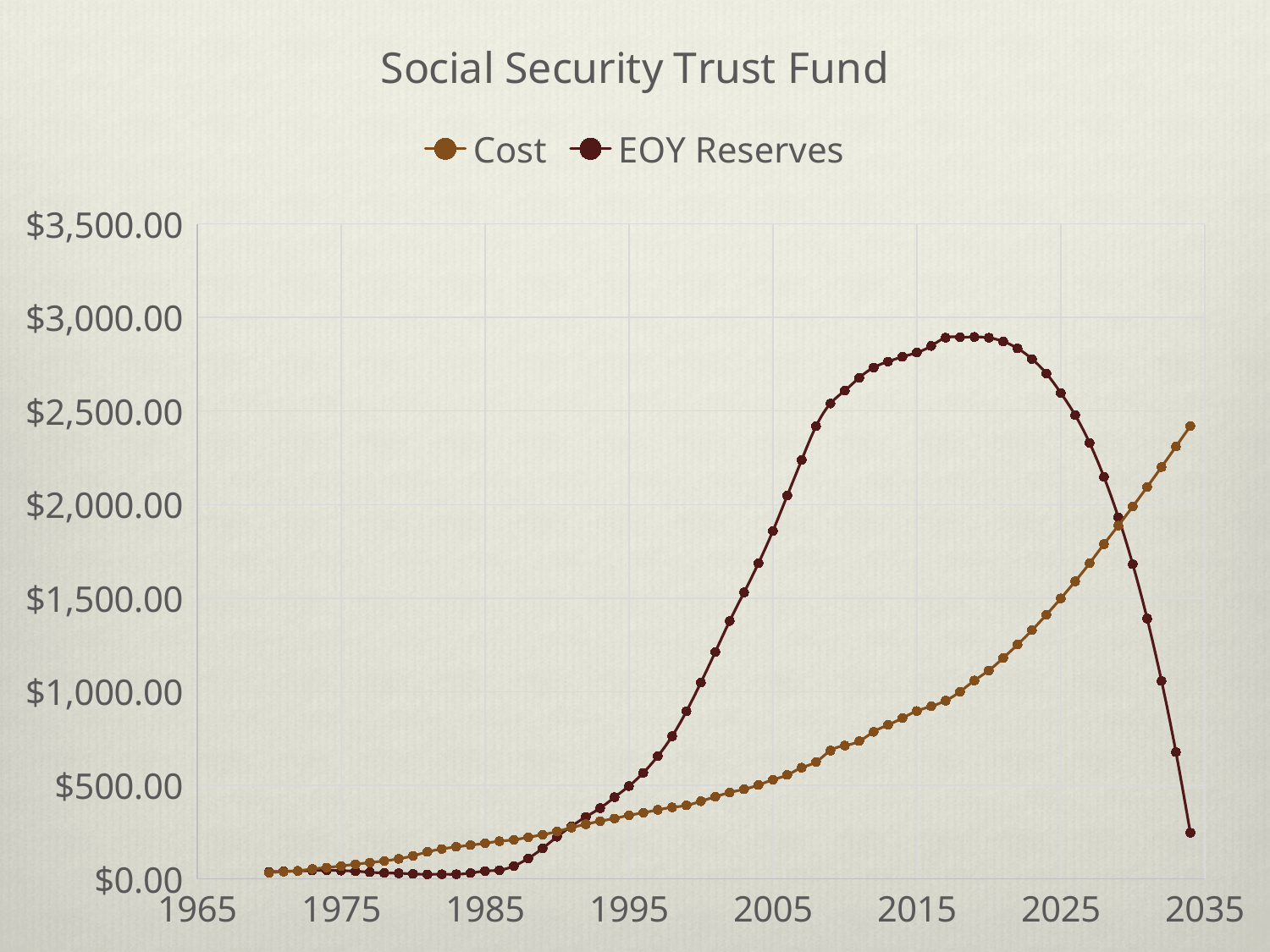
What kind of chart is shown on the slide? line chart What are the two series named in the legend? Cost and EOY Reserves Is the value of EOY Reserves in 2005 greater or less than $1,500.00? greater Is the value of Cost at the last plotted year (around 2034) greater or less than $2,000.00? greater At the last plotted year (around 2034), which series has the larger value, Cost or EOY Reserves? Cost Is the value of EOY Reserves at the last plotted year (around 2034) greater or less than $500.00? less In 2015, which series has the larger value, Cost or EOY Reserves? EOY Reserves Does the EOY Reserves series rise or fall after about 2020? fall What is the title of the chart? Social Security Trust Fund How many series does the legend list? 2 Does the Cost series rise or fall as the years increase along the x axis? rise